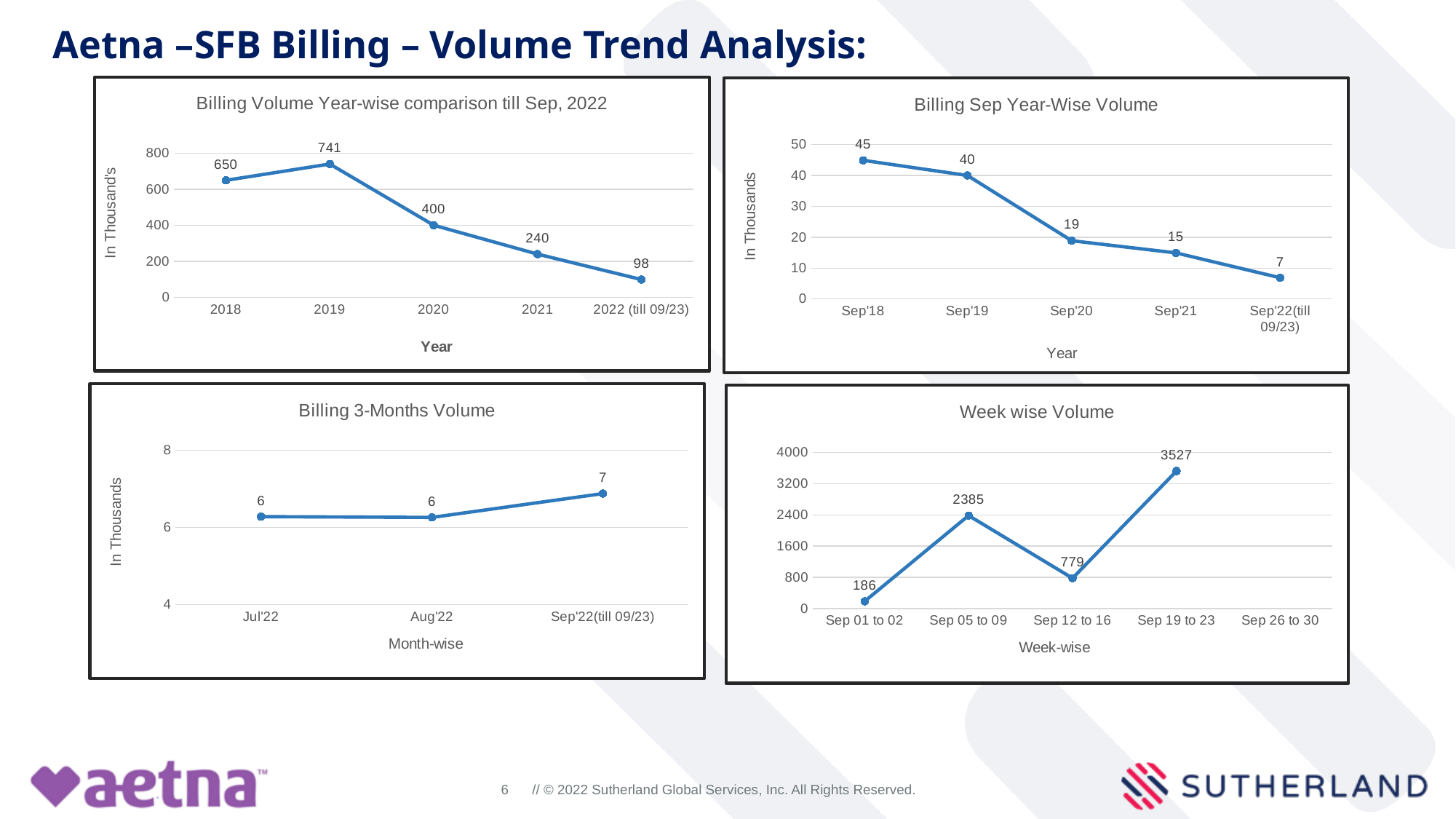
In the 'Billing Sep Year-Wise Volume' chart, which category has the highest value? Sep'18 In the 'Billing Sep Year-Wise Volume' chart, what is the value for Sep'20? 19 In the 'Billing Volume Year-wise comparison till Sep, 2022' chart, what is the difference between the 2018 and 2020 values? 250 In the 'Billing Volume Year-wise comparison till Sep, 2022' chart, which year has the lowest value? 2022 (till 09/23) In the 'Billing Sep Year-Wise Volume' chart, how many data points are plotted? 5 In the 'Billing 3-Months Volume' chart, what is the label of the y axis? In Thousands In the 'Billing 3-Months Volume' chart, what is the value for Sep'22(till 09/23)? 7 In the 'Billing Volume Year-wise comparison till Sep, 2022' chart, what is the value for 2019? 741 In the 'Week wise Volume' chart, which week has the highest value? Sep 19 to 23 In the 'Billing Sep Year-Wise Volume' chart, do the values rise or fall from Sep'18 to Sep'22(till 09/23)? fall In the 'Week wise Volume' chart, which is larger, the value for Sep 05 to 09 or the value for Sep 12 to 16? Sep 05 to 09 In the 'Week wise Volume' chart, what is the value for Sep 12 to 16? 779